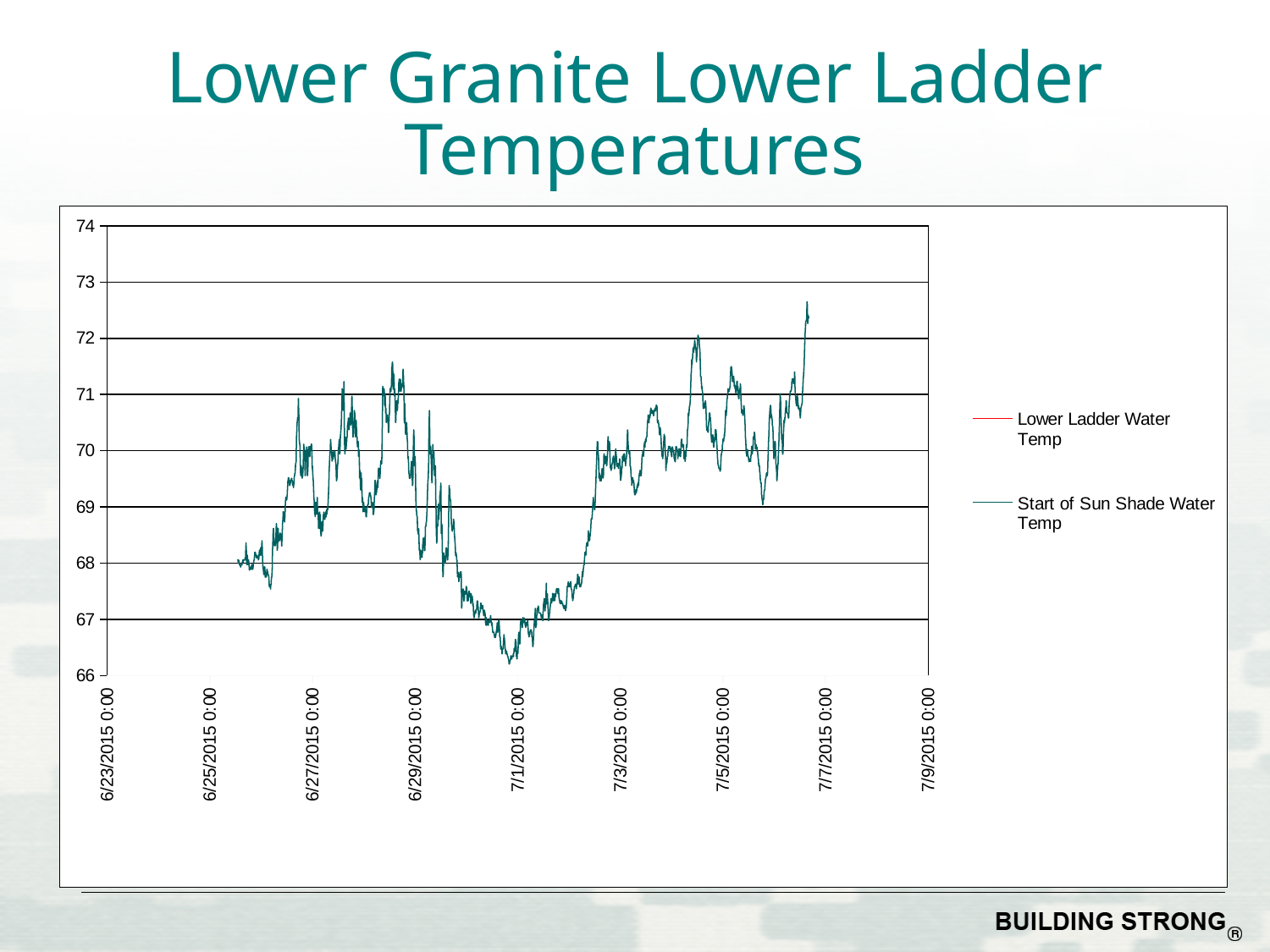
Is the peak reached around 7/4/2015 greater or less than 71? greater How many series does the legend list? 2 How many date labels are shown on the horizontal axis? 9 What is the highest value shown on the vertical axis? 74 Is the highest value reached by the line, just before 7/7/2015, greater or less than 72? greater What are the two series named in the legend? Lower Ladder Water Temp; Start of Sun Shade Water Temp What is the title of the slide's chart? Lower Granite Lower Ladder Temperatures Is the lowest value reached by the line, around 7/1/2015, greater or less than 67? less Do the values generally rise or fall between 7/1/2015 and 7/7/2015? rise What kind of chart is shown on the slide? line chart Do the values generally rise or fall between 6/29/2015 and 7/1/2015? fall